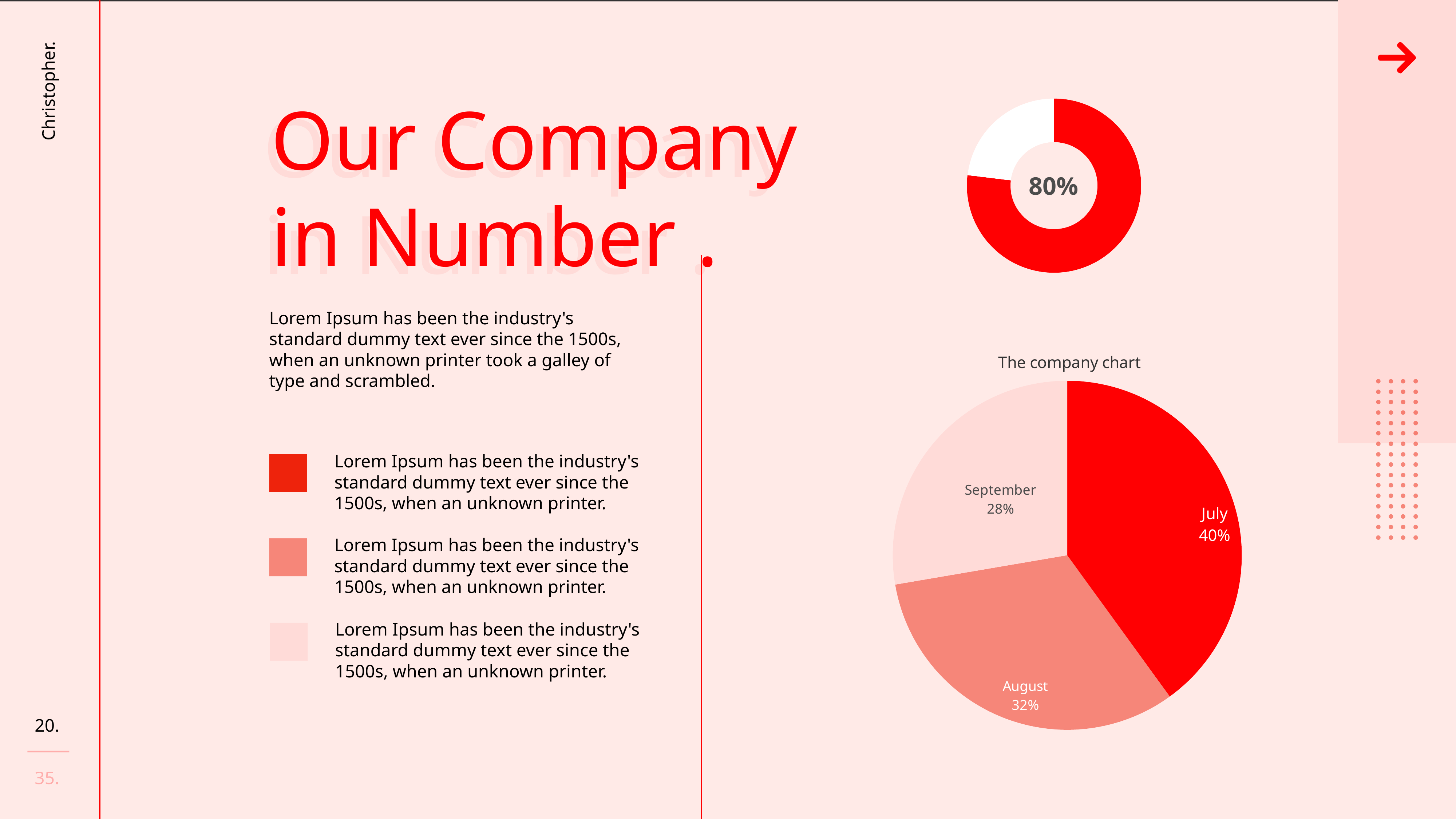
In "The company chart" pie chart, which month has the smallest slice? September In "The company chart" pie chart, what is the difference between July's share and September's share? 12% In "The company chart" pie chart, what share does August have? 32% In "The company chart" pie chart, what share does September have? 28% What is the title of the pie chart at the bottom right of the slide? The company chart In "The company chart" pie chart, which is larger, August or September? August What kind of chart is the chart at the top right of the slide showing 80%? Donut chart What kind of chart is "The company chart"? Pie chart How many slices does "The company chart" pie chart have? 3 In "The company chart" pie chart, what share does July have? 40% What percentage is shown in the centre of the donut chart at the top right of the slide? 80% In "The company chart" pie chart, which month has the largest slice? July